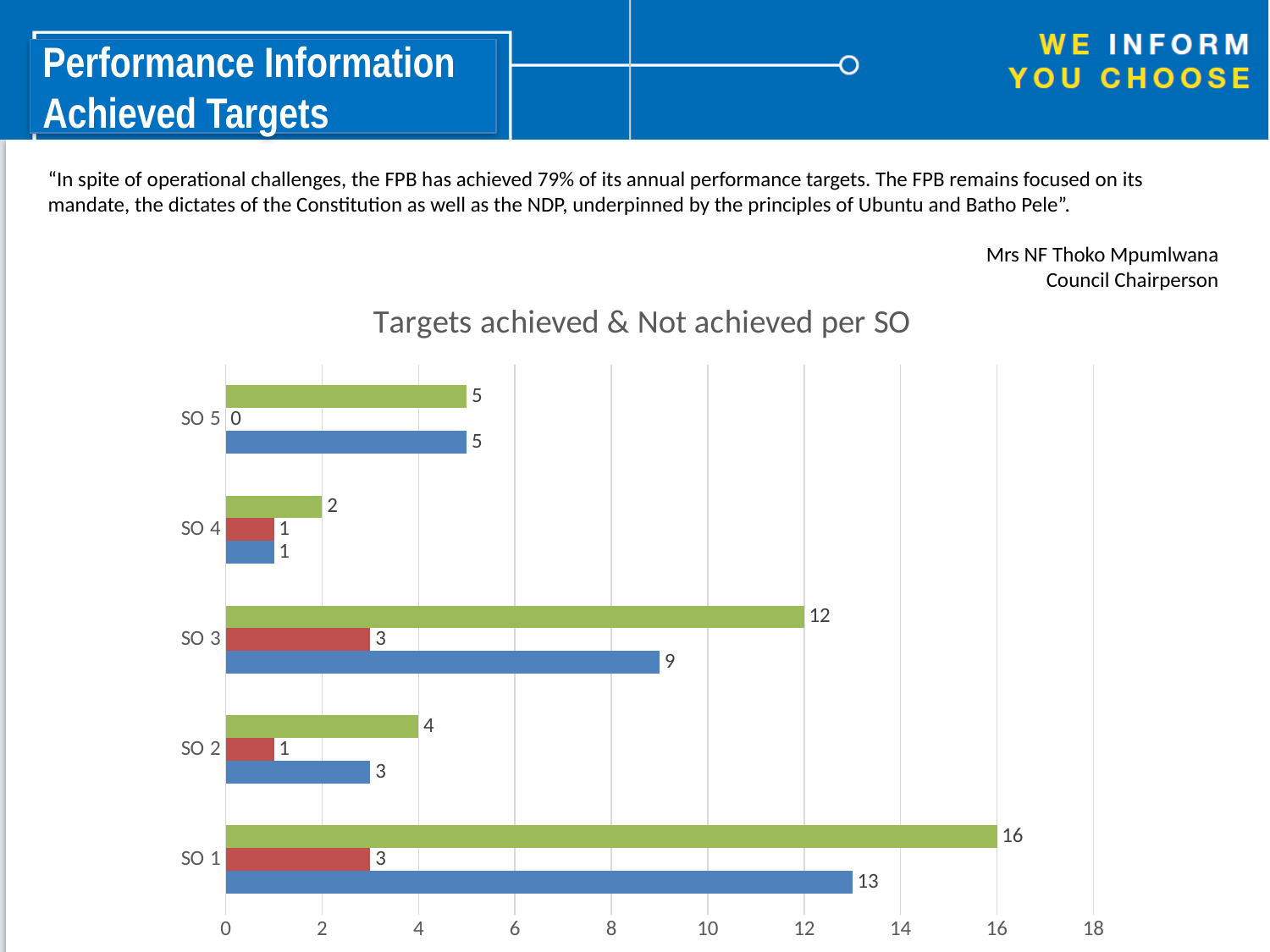
What is the difference between the green bar values of SO 3 and SO 2? 8 Which SO category has the lowest blue bar value? SO 4 What is the value of the blue bar for SO 2? 3 What is the title of the chart? Targets achieved & Not achieved per SO Which is larger, the blue bar for SO 3 or the blue bar for SO 5? SO 3 What is the value of the blue bar for SO 3? 9 What is the value of the green bar for SO 1? 16 What is the difference between the green bar and the blue bar for SO 1? 3 What is the value of the red bar for SO 5? 0 What kind of chart is shown on the slide? bar chart Which SO category has the highest green bar value? SO 1 How many SO categories are shown on the chart? 5